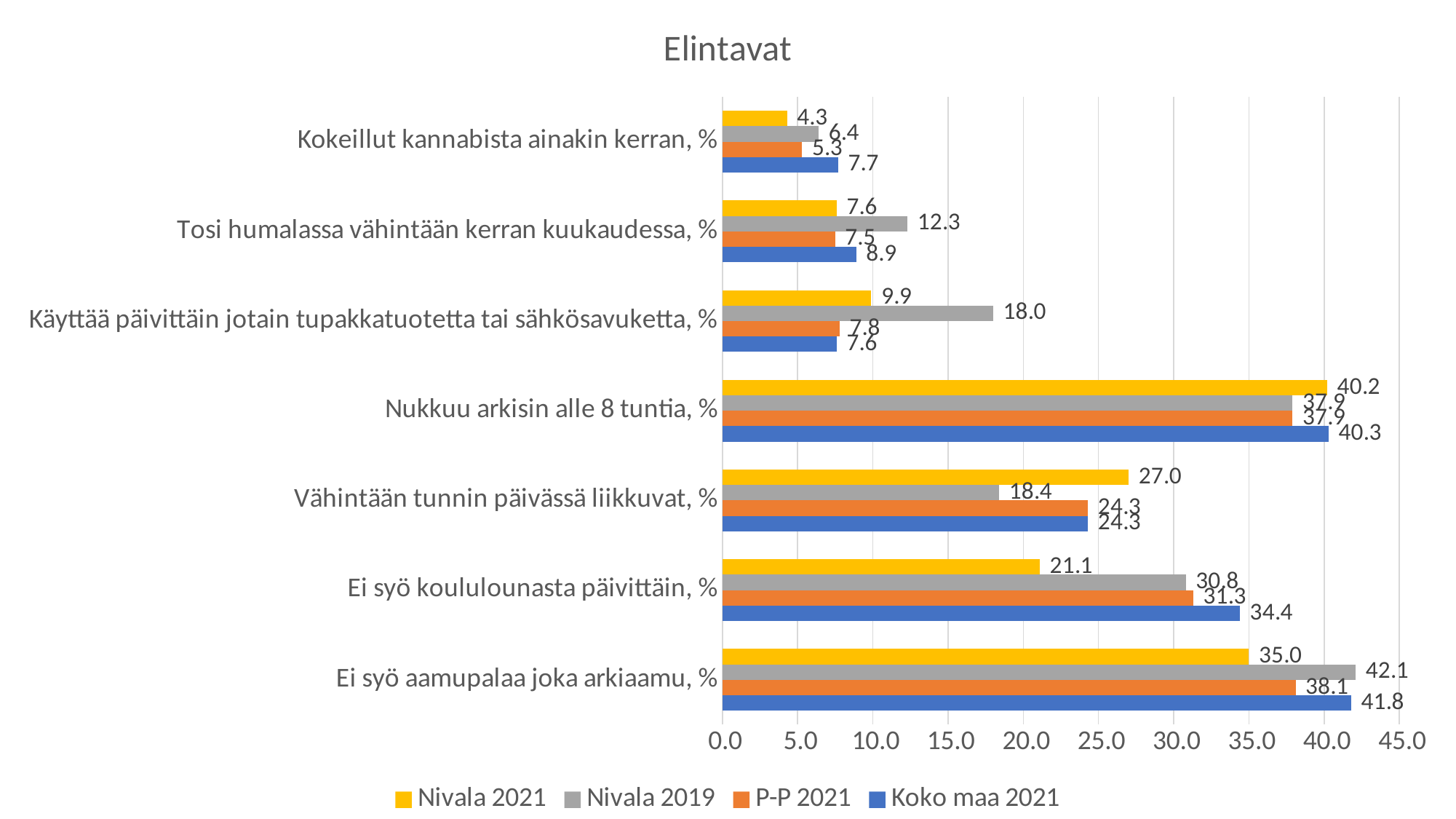
Which category has the lowest value for Nivala 2021? Kokeillut kannabista ainakin kerran, % What is the difference between Nivala 2019 and Nivala 2021 in the category "Tosi humalassa vähintään kerran kuukaudessa, %"? 4.7 What is the difference between Koko maa 2021 and Nivala 2021 in the category "Ei syö koululounasta päivittäin, %"? 13.3 How many series does the legend list? 4 What is the value for P-P 2021 in the category "Kokeillut kannabista ainakin kerran, %"? 5.3 Which series has the highest value in the category "Ei syö aamupalaa joka arkiaamu, %"? Nivala 2019 What kind of chart is shown on the slide? Bar chart How many categories are shown on the chart? 7 In the category "Vähintään tunnin päivässä liikkuvat, %", which is larger: Nivala 2021 or Nivala 2019? Nivala 2021 What is the value for Nivala 2021 in the category "Ei syö aamupalaa joka arkiaamu, %"? 35.0 What is the value for Nivala 2019 in the category "Käyttää päivittäin jotain tupakkatuotetta tai sähkösavuketta, %"? 18.0 What is the value for Koko maa 2021 in the category "Ei syö koululounasta päivittäin, %"? 34.4